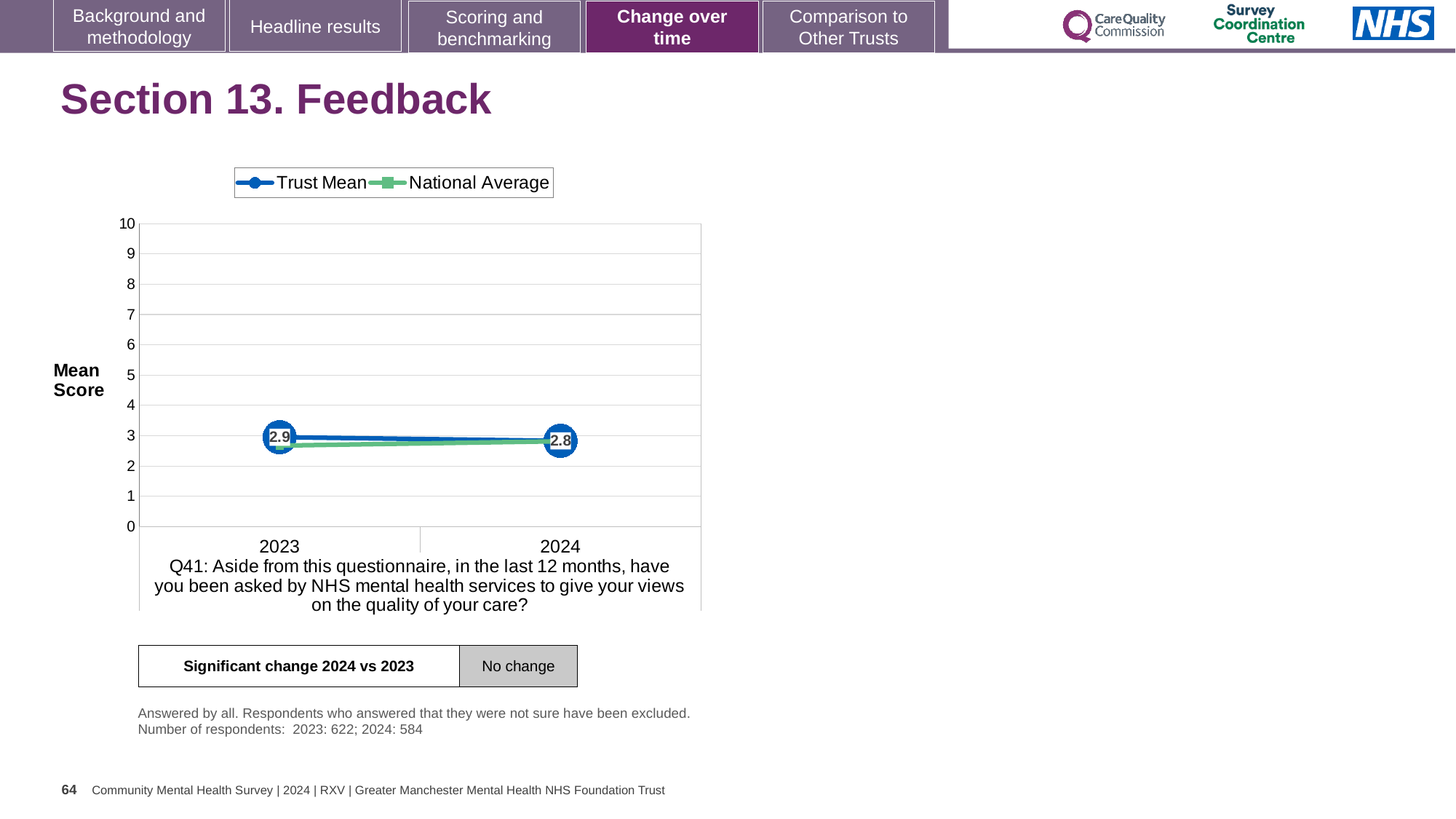
Is the National Average value for 2023 greater or less than 3? less Is the Trust Mean value for 2024 greater or less than 5? less By how much did the Trust Mean change from 2023 to 2024? 0.1 What kind of chart is shown on the slide? line chart What is the Trust Mean value for 2023? 2.9 Which year has the higher Trust Mean, 2023 or 2024? 2023 In which year is the Trust Mean highest? 2023 How many series does the legend list? 2 What is the Trust Mean value for 2024? 2.8 Does the Trust Mean rise or fall from 2023 to 2024? fall How many years are plotted on the x axis? 2 What is the label on the y axis of the chart? Mean Score